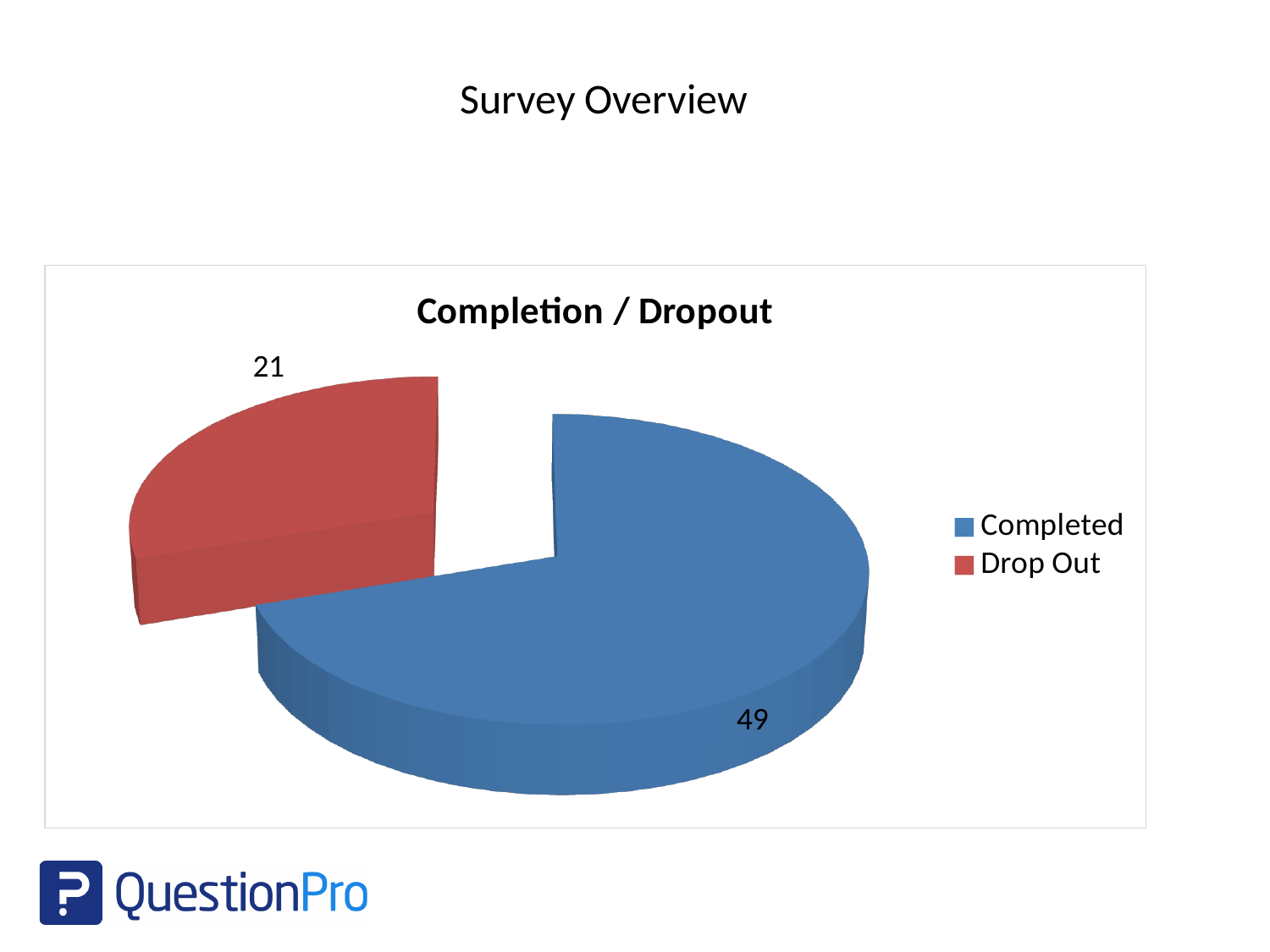
What is the total of all slices in the pie chart? 70 What kind of chart is shown? Pie chart Which category has the smallest slice? Drop Out What is the value for Completed? 49 Which is larger, Completed or Drop Out? Completed What is the difference between the Completed and Drop Out values? 28 How many slices does the pie chart have? 2 Which category has the largest slice? Completed What share of the pie does Completed represent? 70% What colour is the Drop Out slice? Red What is the title of the chart? Completion / Dropout What is the value for Drop Out? 21